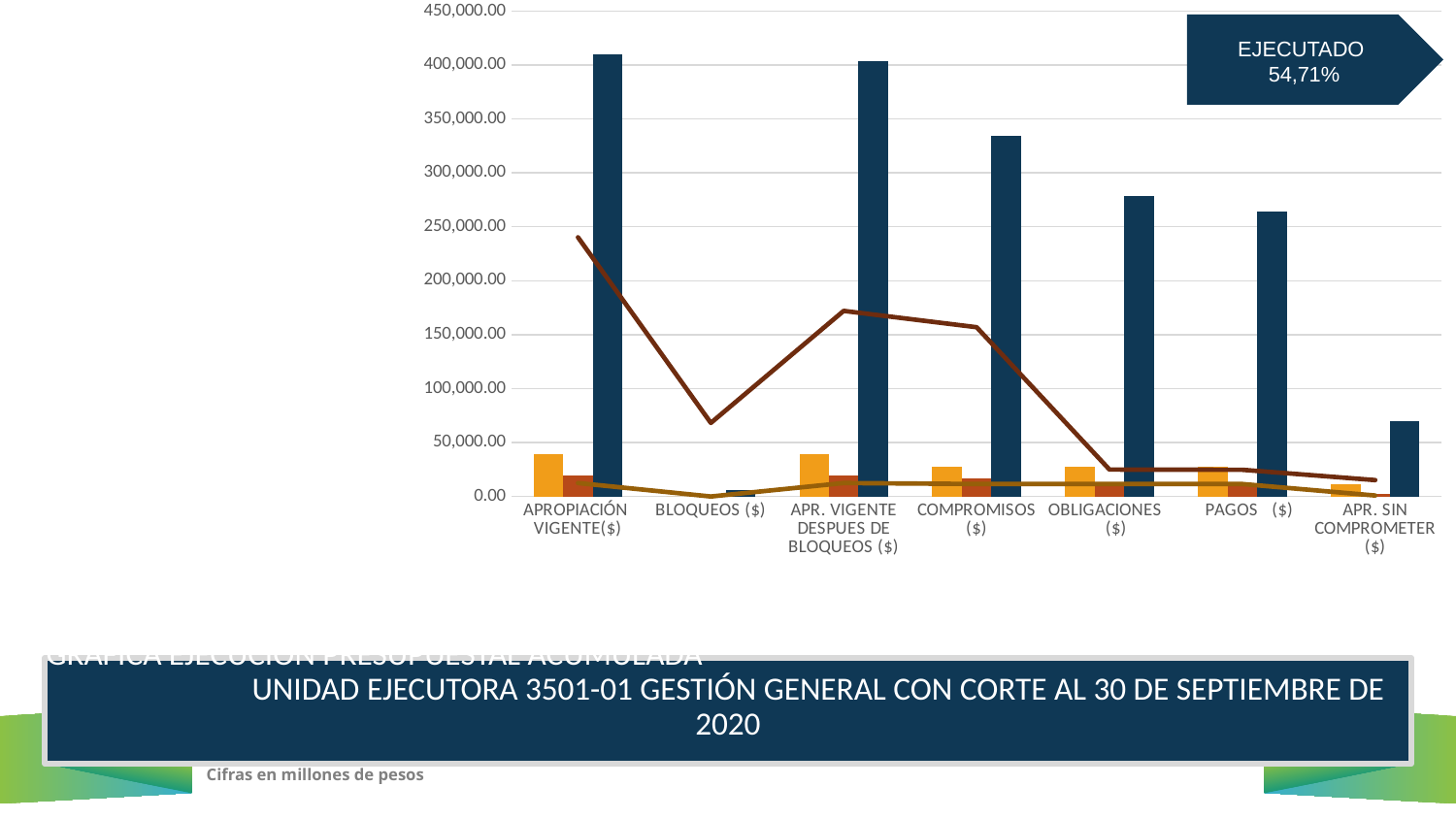
How many categories are shown along the x axis of the chart? 7 What kind of chart is shown on the slide? A combined bar and line chart Is the dark brown line at APROPIACIÓN VIGENTE($) greater or less than 200,000.00? greater Is the dark blue bar for BLOQUEOS ($) greater or less than 50,000.00? less Is the dark blue bar for APR. SIN COMPROMETER ($) greater or less than 50,000.00? greater Which category has the lowest dark blue bar? BLOQUEOS ($) Which has the taller dark blue bar, COMPROMISOS ($) or OBLIGACIONES ($)? COMPROMISOS ($) What is the highest value shown on the vertical axis of the chart? 450,000.00 What percentage is shown in the EJECUTADO callout on the chart? 54,71%